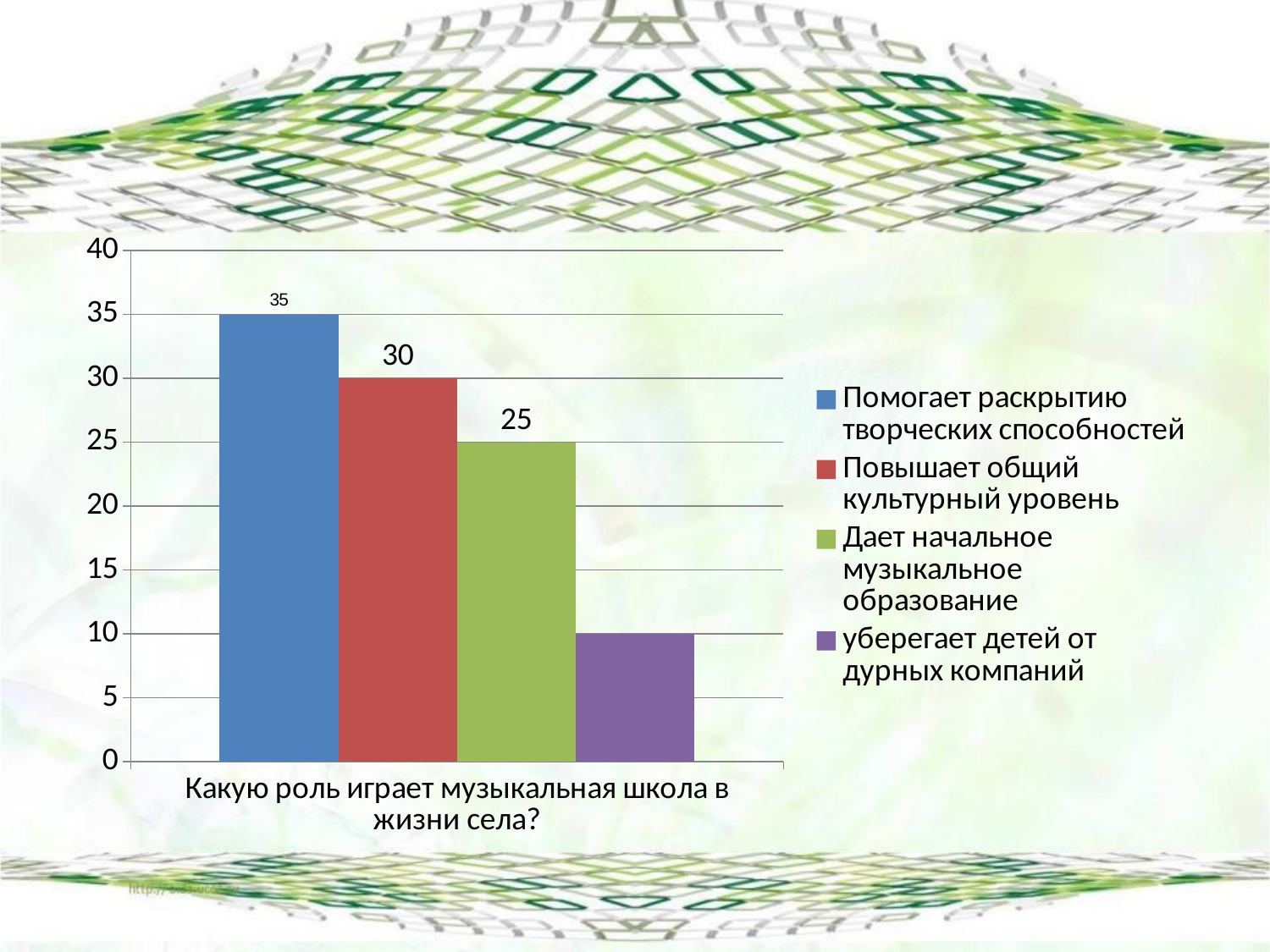
Which series has the highest value? Помогает раскрытию творческих способностей What kind of chart is shown on the slide? bar chart What is the value for "Повышает общий культурный уровень"? 30 Which series has the lowest value? уберегает детей от дурных компаний What is the value for "Дает начальное музыкальное образование"? 25 What is the category label shown on the x axis? Какую роль играет музыкальная школа в жизни села? What is the value for "уберегает детей от дурных компаний"? 10 Which is larger: the value for "Повышает общий культурный уровень" or the value for "уберегает детей от дурных компаний"? Повышает общий культурный уровень What is the value for "Помогает раскрытию творческих способностей"? 35 What is the difference between the values for "Помогает раскрытию творческих способностей" and "Дает начальное музыкальное образование"? 10 Is the value for "Дает начальное музыкальное образование" greater or less than 20? greater How many series does the legend list? 4